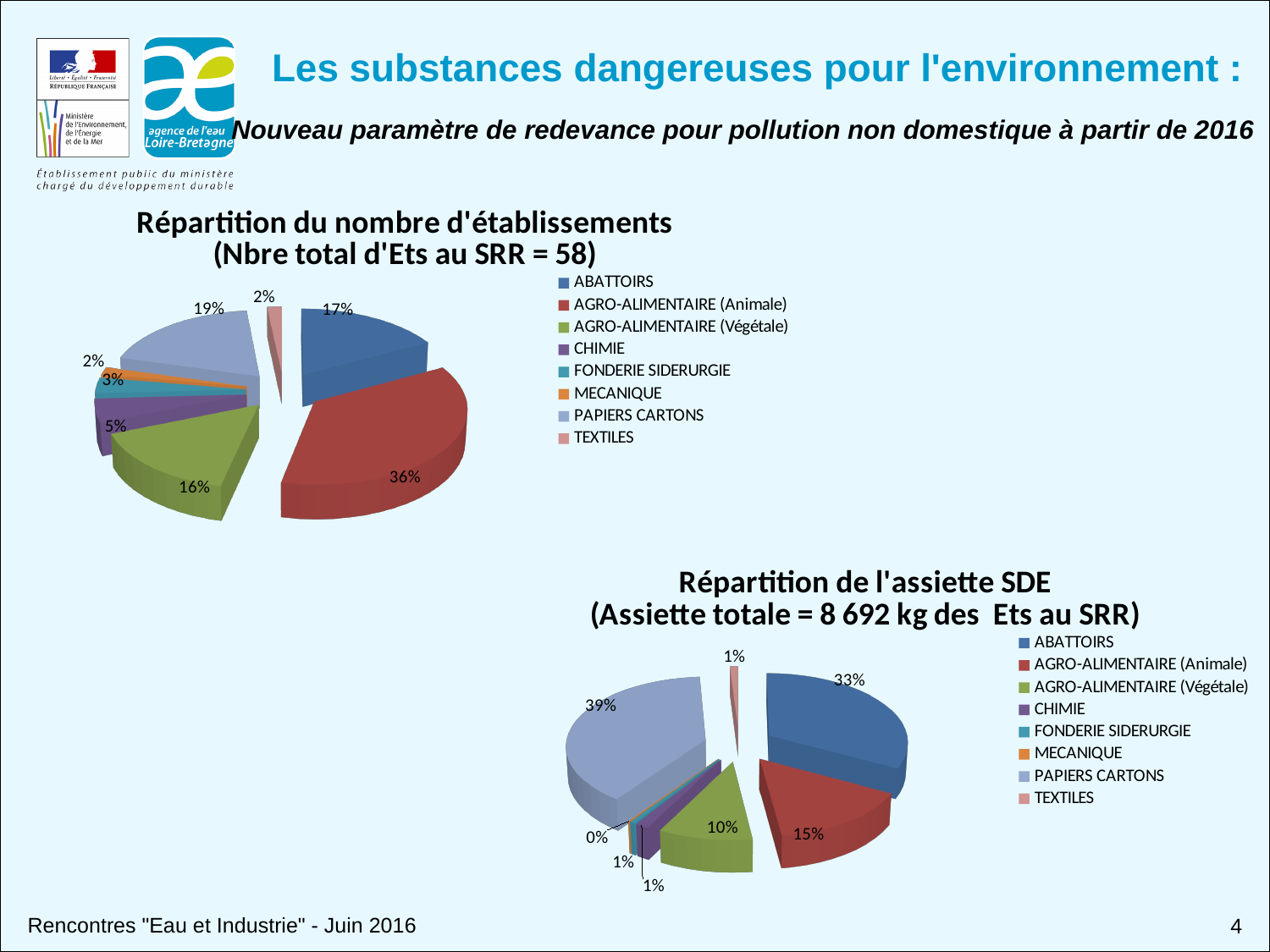
What kind of chart is 'Répartition de l'assiette SDE'? Pie chart In the chart 'Répartition du nombre d'établissements', which category has the largest slice? AGRO-ALIMENTAIRE (Animale) In the chart 'Répartition de l'assiette SDE', which category has the largest slice? PAPIERS CARTONS In the chart 'Répartition du nombre d'établissements', what is the difference between the ABATTOIRS share and the AGRO-ALIMENTAIRE (Végétale) share? 1% How many categories does the legend of the chart 'Répartition du nombre d'établissements' list? 8 In the chart 'Répartition de l'assiette SDE', what is the difference between the PAPIERS CARTONS share and the ABATTOIRS share? 6% In the chart 'Répartition du nombre d'établissements', what share is PAPIERS CARTONS? 19% In the chart 'Répartition de l'assiette SDE', which is larger: AGRO-ALIMENTAIRE (Animale) or AGRO-ALIMENTAIRE (Végétale)? AGRO-ALIMENTAIRE (Animale) In the chart 'Répartition du nombre d'établissements', what share is CHIMIE? 5% In the chart 'Répartition de l'assiette SDE', what share is ABATTOIRS? 33%